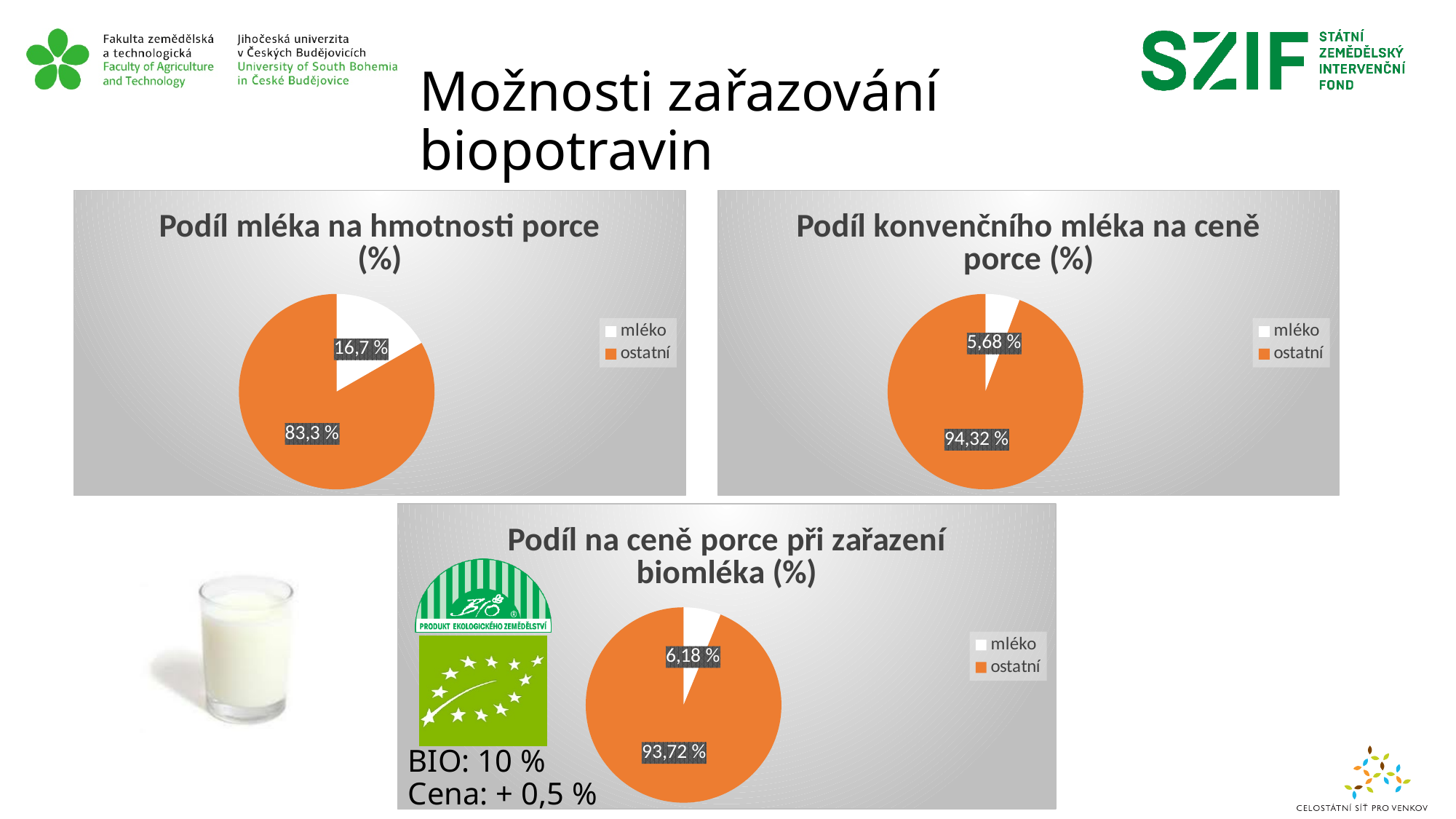
In the chart titled "Podíl na ceně porce při zařazení biomléka (%)", what is the value for ostatní? 93,72 % In the chart titled "Podíl konvenčního mléka na ceně porce (%)", which slice is the smallest? mléko In the chart titled "Podíl mléka na hmotnosti porce (%)", which slice is the largest? ostatní In the chart titled "Podíl mléka na hmotnosti porce (%)", what is the value for mléko? 16,7 % In the chart titled "Podíl konvenčního mléka na ceně porce (%)", what is the value for mléko? 5,68 % In the chart titled "Podíl mléka na hmotnosti porce (%)", what is the value for ostatní? 83,3 % In the chart titled "Podíl na ceně porce při zařazení biomléka (%)", what is the value for mléko? 6,18 % What kind of chart is the chart titled "Podíl na ceně porce při zařazení biomléka (%)"? pie chart How many slices does the chart titled "Podíl mléka na hmotnosti porce (%)" have? 2 In the chart titled "Podíl konvenčního mléka na ceně porce (%)", what colour is the ostatní slice? orange In the chart titled "Podíl mléka na hmotnosti porce (%)", what is the difference between the ostatní and mléko values? 66,6 % In the chart titled "Podíl konvenčního mléka na ceně porce (%)", what is the value for ostatní? 94,32 %